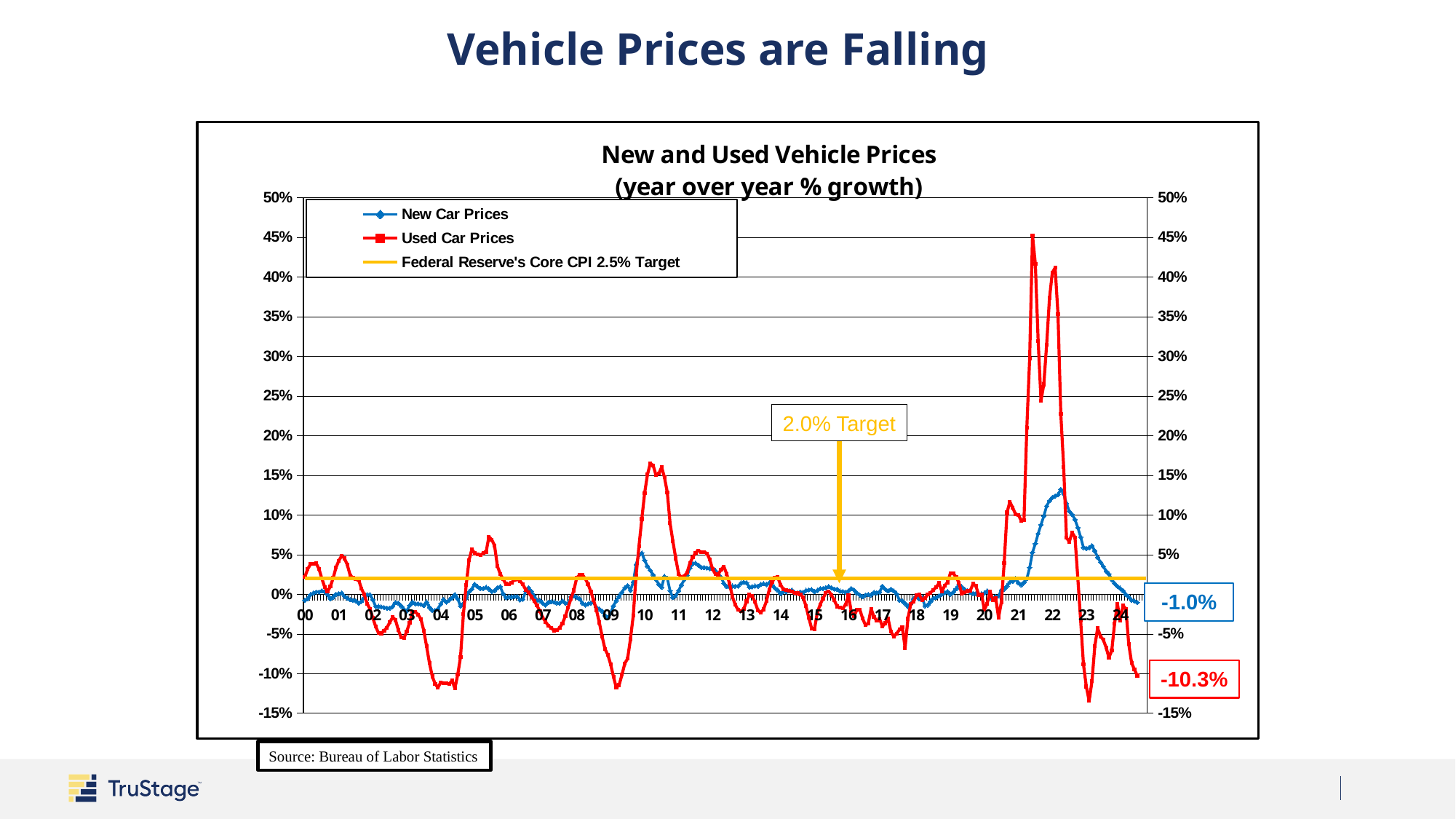
What is the latest labelled value for Used Car Prices? -10.3% What is the difference between the latest labelled New Car Prices value (-1.0%) and the latest labelled Used Car Prices value (-10.3%)? 9.3 percentage points Is the peak of Used Car Prices around 2021 greater or less than 40%? greater At the end of the series, which is lower: New Car Prices or Used Car Prices? Used Car Prices Is the peak of New Car Prices around 2022 greater or less than 10%? greater What is the title of the chart? New and Used Vehicle Prices (year over year % growth) From its peak around 2022 to 2024, do New Car Prices rise or fall? Fall How many series does the legend list? 3 What is the latest labelled value for New Car Prices? -1.0% What kind of chart is shown on the slide? Line chart Which series reaches the highest value on the chart? Used Car Prices Is the lowest point of Used Car Prices around 2023 greater or less than -10%? less